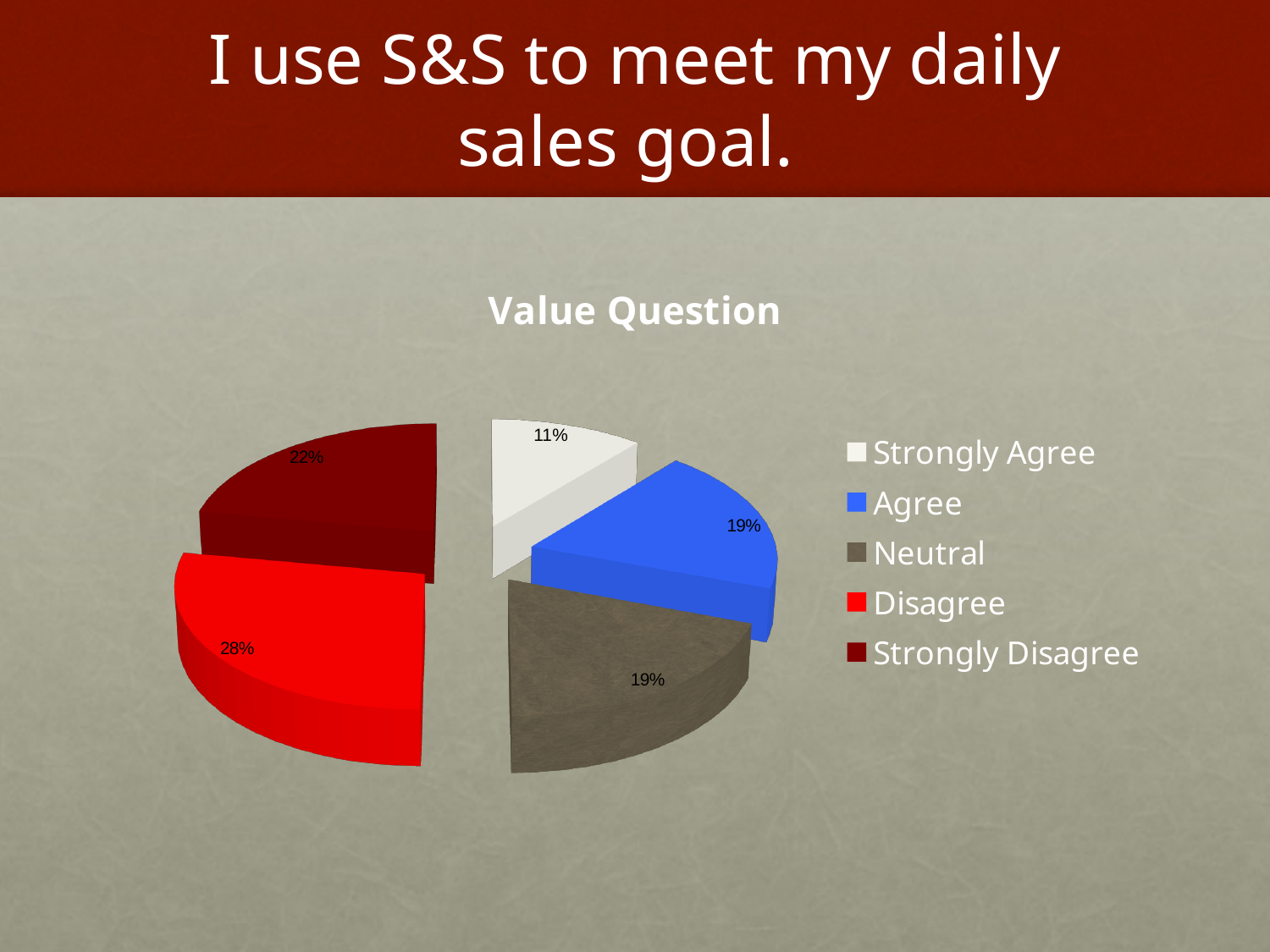
Which colour represents Agree in the legend? Blue Which is larger, the share for Strongly Disagree or the share for Neutral? Strongly Disagree How many response categories does the pie chart show? 5 What is the difference in percentage points between Disagree and Strongly Agree? 17 What percentage of respondents chose Disagree? 28% Which response category has the largest share of the pie? Disagree What percentage of respondents chose Strongly Agree? 11% What percentage of respondents chose Agree? 19% Which response category has the smallest share of the pie? Strongly Agree What percentage of respondents chose Strongly Disagree? 22% What kind of chart is shown on the slide? Pie chart What is the title of the chart? Value Question